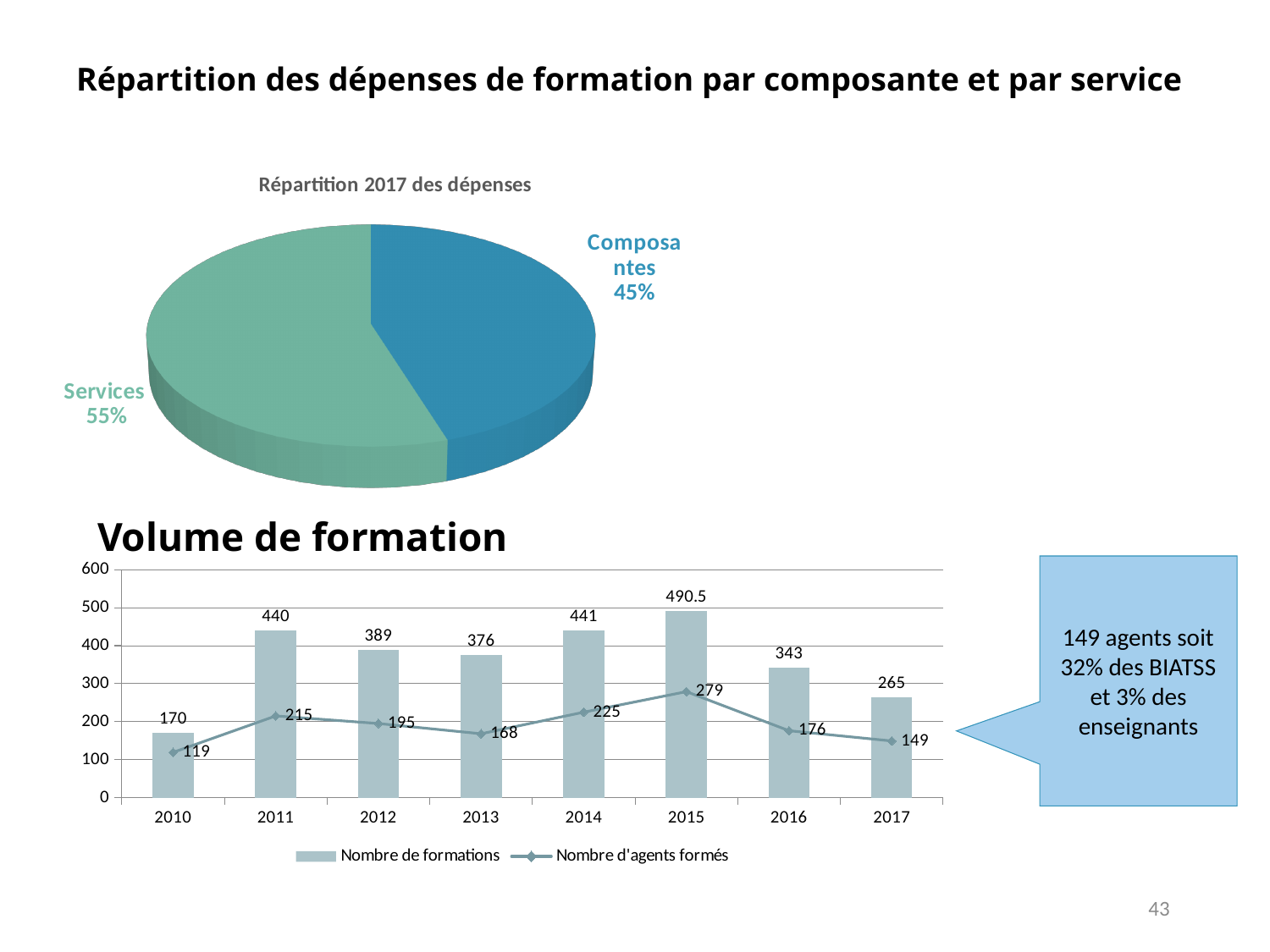
In the 'Volume de formation' chart, how many series does the legend list? 2 In the 'Volume de formation' chart, which year has the lowest 'Nombre d'agents formés'? 2010 In the 'Répartition 2017 des dépenses' pie chart, what share do Composantes account for? 45% In the 'Répartition 2017 des dépenses' pie chart, which slice is larger, Services or Composantes? Services In the 'Volume de formation' chart, what is the difference between 'Nombre de formations' in 2011 and in 2017? 175 In the 'Volume de formation' chart, does 'Nombre de formations' rise or fall from 2015 to 2017? fall In the 'Répartition 2017 des dépenses' pie chart, what share do Services account for? 55% In the 'Volume de formation' chart, what is the value of 'Nombre de formations' for 2015? 490.5 In the 'Volume de formation' chart, which year has the highest 'Nombre de formations'? 2015 In the 'Volume de formation' chart, what is the value of 'Nombre d'agents formés' for 2017? 149 In the 'Volume de formation' chart, is 'Nombre de formations' for 2012 greater or less than 'Nombre de formations' for 2013? greater In the 'Volume de formation' chart, how many years are shown on the x axis? 8